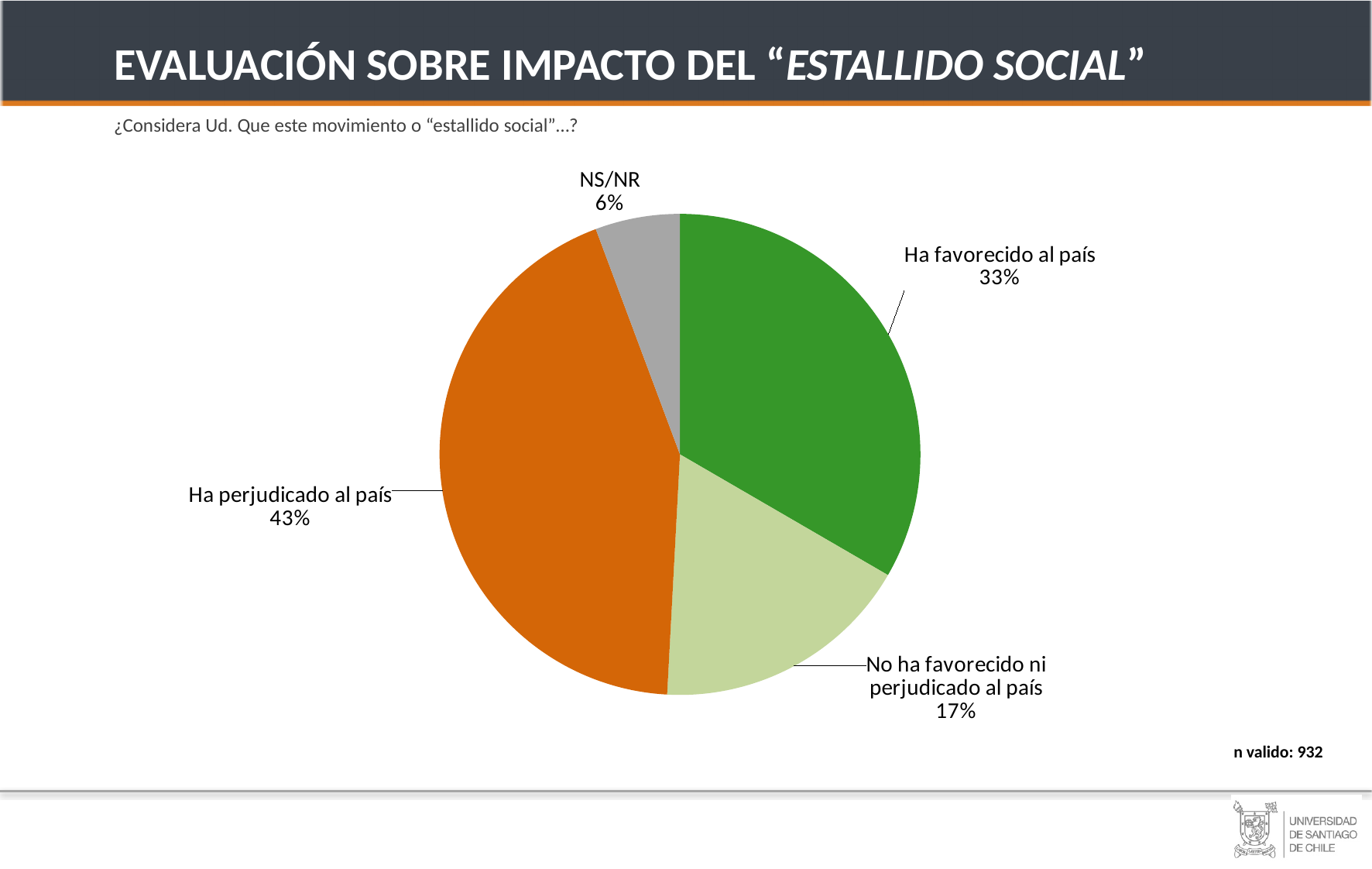
What type of chart is shown on the slide? Pie chart What colour is the slice for "Ha perjudicado al país"? Orange Which response has the largest share of the pie? Ha perjudicado al país What percentage of respondents answered "Ha favorecido al país"? 33% What is the difference in percentage points between "Ha perjudicado al país" and "Ha favorecido al país"? 10 How many slices does the pie chart have? 4 Which response has the smallest share of the pie? NS/NR What is the valid sample size (n valido) shown on the slide? 932 What percentage of respondents answered "Ha perjudicado al país"? 43% What percentage of respondents answered "NS/NR"? 6% Which is larger: the share for "Ha favorecido al país" or the share for "No ha favorecido ni perjudicado al país"? Ha favorecido al país What percentage of respondents answered "No ha favorecido ni perjudicado al país"? 17%